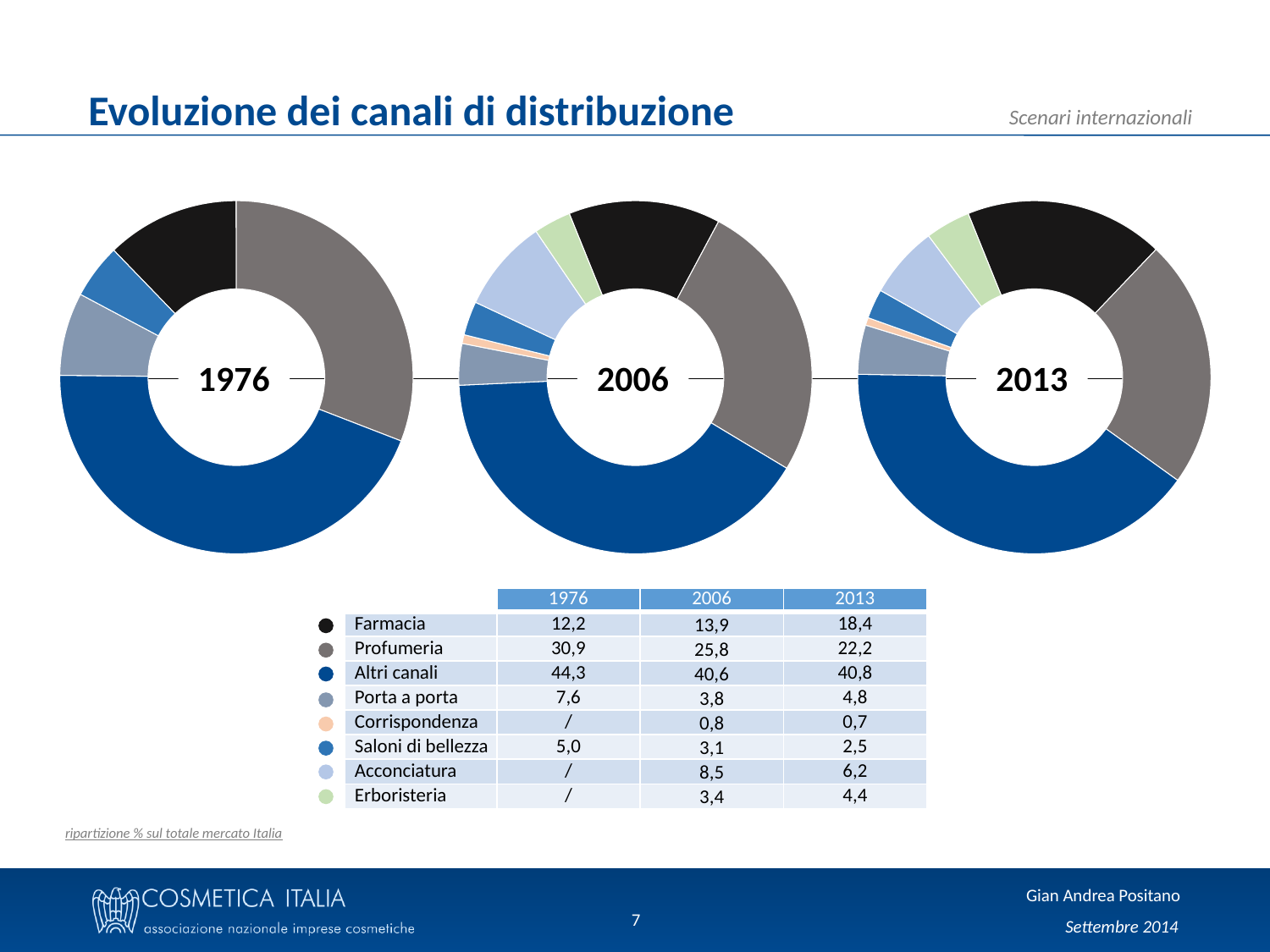
How many categories have a value in the 1976 chart (excluding those marked '/')? 5 How many categories does the legend list? 8 Does the Profumeria share rise or fall from the 1976 chart to the 2013 chart? Fall What kind of chart is used for 1976, 2006 and 2013? Doughnut (pie) chart In the 2006 chart, which is larger: Profumeria or Farmacia? Profumeria By how much did the Farmacia share increase from the 1976 chart to the 2013 chart? 6,2 In the 2006 chart, what is the value for Acconciatura? 8,5 In the 1976 chart, what is the value for Profumeria? 30,9 In the 2013 chart, which category has the smallest share? Corrispondenza In the 2013 chart, what is the value for Farmacia? 18,4 In the 2006 chart, which category has the largest share? Altri canali What colour represents Farmacia in the charts? Black